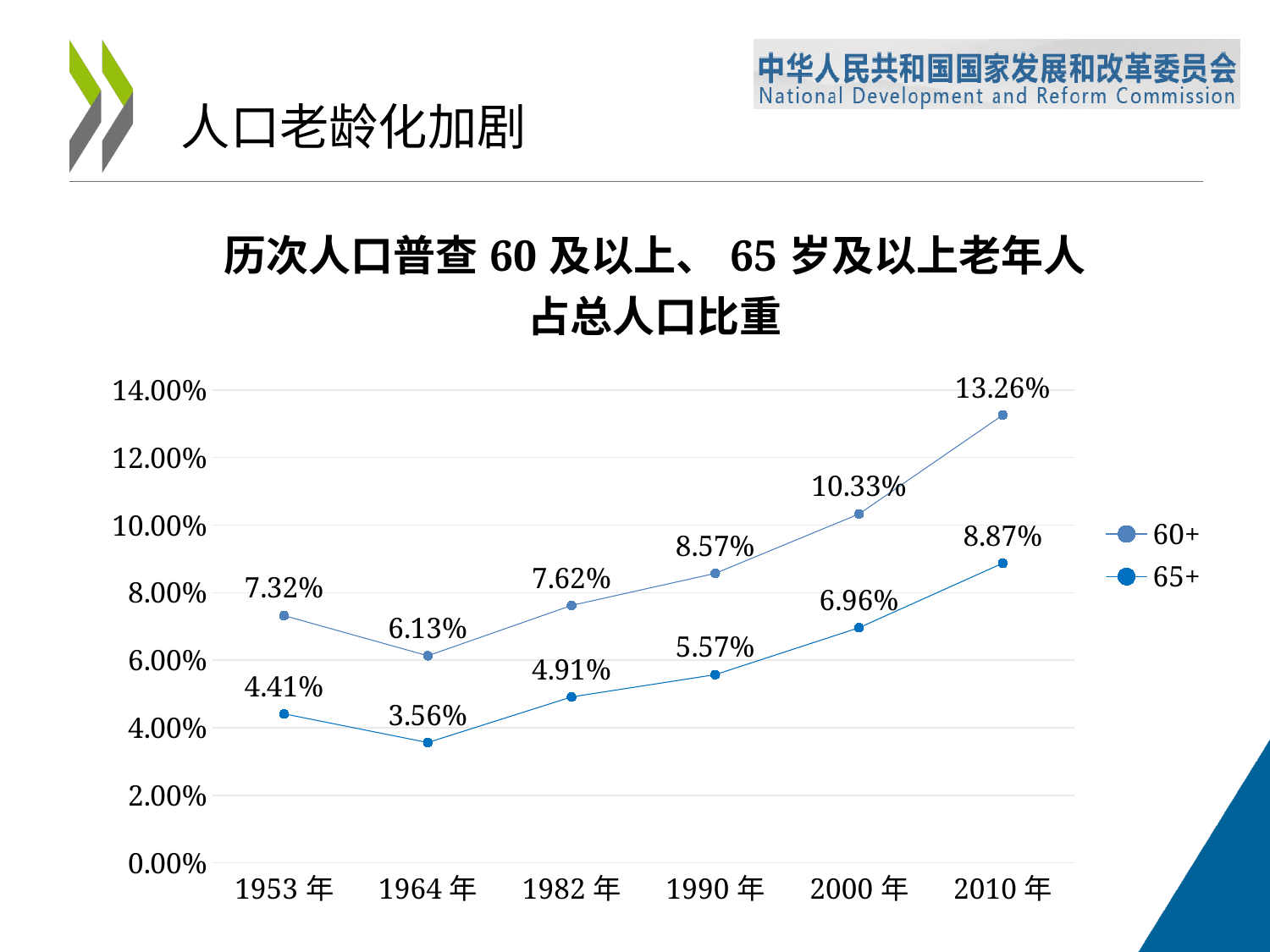
What is the value for the 60+ series in 1982年? 7.62% Which is larger: the 60+ value in 1953年 or the 60+ value in 1964年? 1953年 What are the two series named in the legend? 60+ and 65+ What is the value for the 60+ series in 2010年? 13.26% In which year is the 60+ series lowest? 1964年 In which year is the 65+ series highest? 2010年 What is the difference between the 60+ and 65+ values in 2000年? 3.37% What kind of chart is shown on the slide? line chart Does the 65+ series rise or fall from 1964年 to 2010年? rise How many census years are shown on the x axis? 6 How many series does the legend list? 2 What is the value for the 65+ series in 1964年? 3.56%